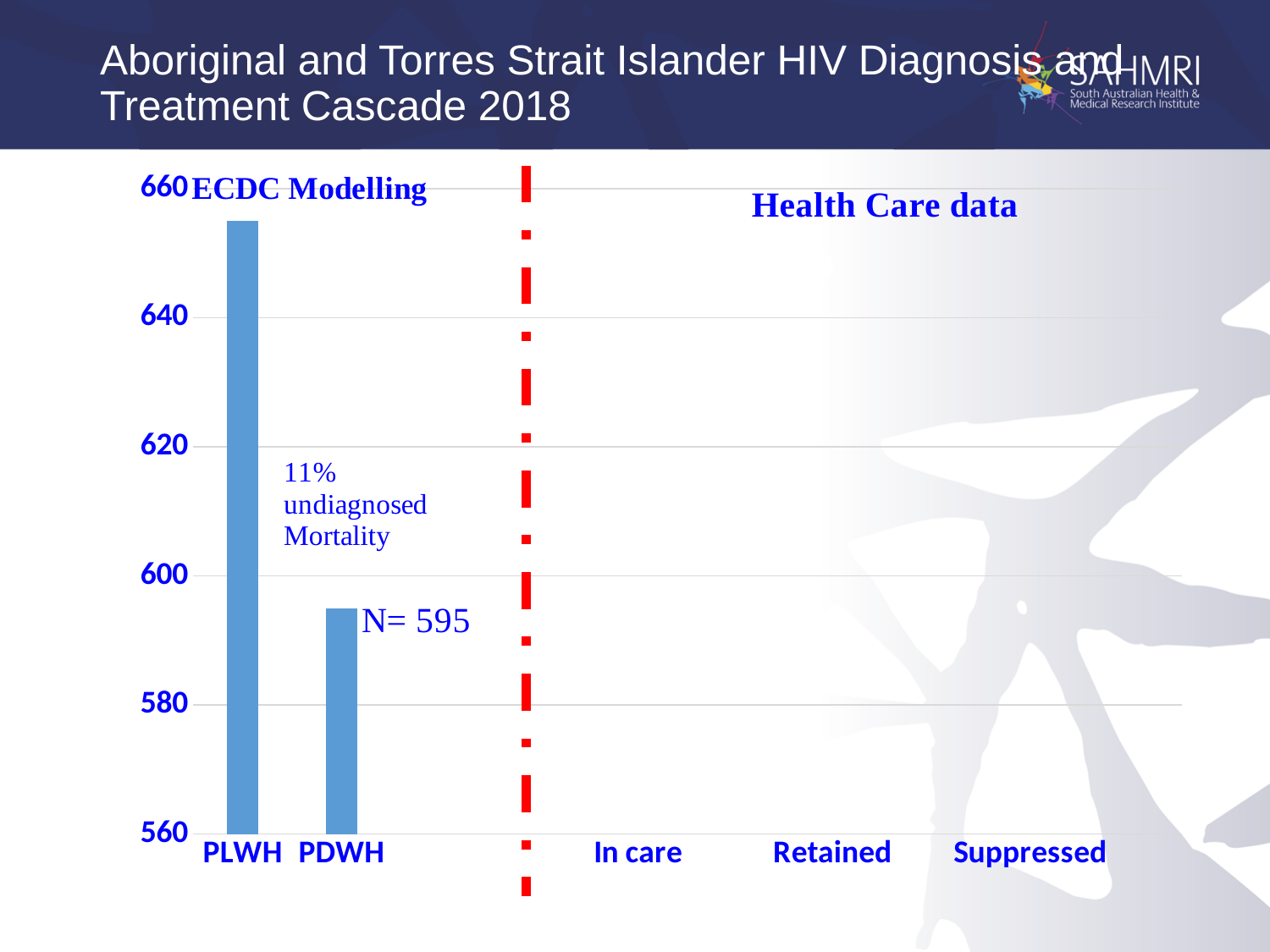
Is the value for PLWH greater or less than 660? less Is the value for PLWH greater or less than 640? greater What is the value labelled for the PDWH bar? 595 What kind of chart is shown on the slide? bar chart Which category has the highest bar? PLWH How many category labels are shown along the x axis? 5 Which bar is taller, PLWH or PDWH? PLWH Is the value for PDWH greater or less than 600? less What is the title of the slide containing the chart? Aboriginal and Torres Strait Islander HIV Diagnosis and Treatment Cascade 2018 What is the lowest value shown on the y axis? 560